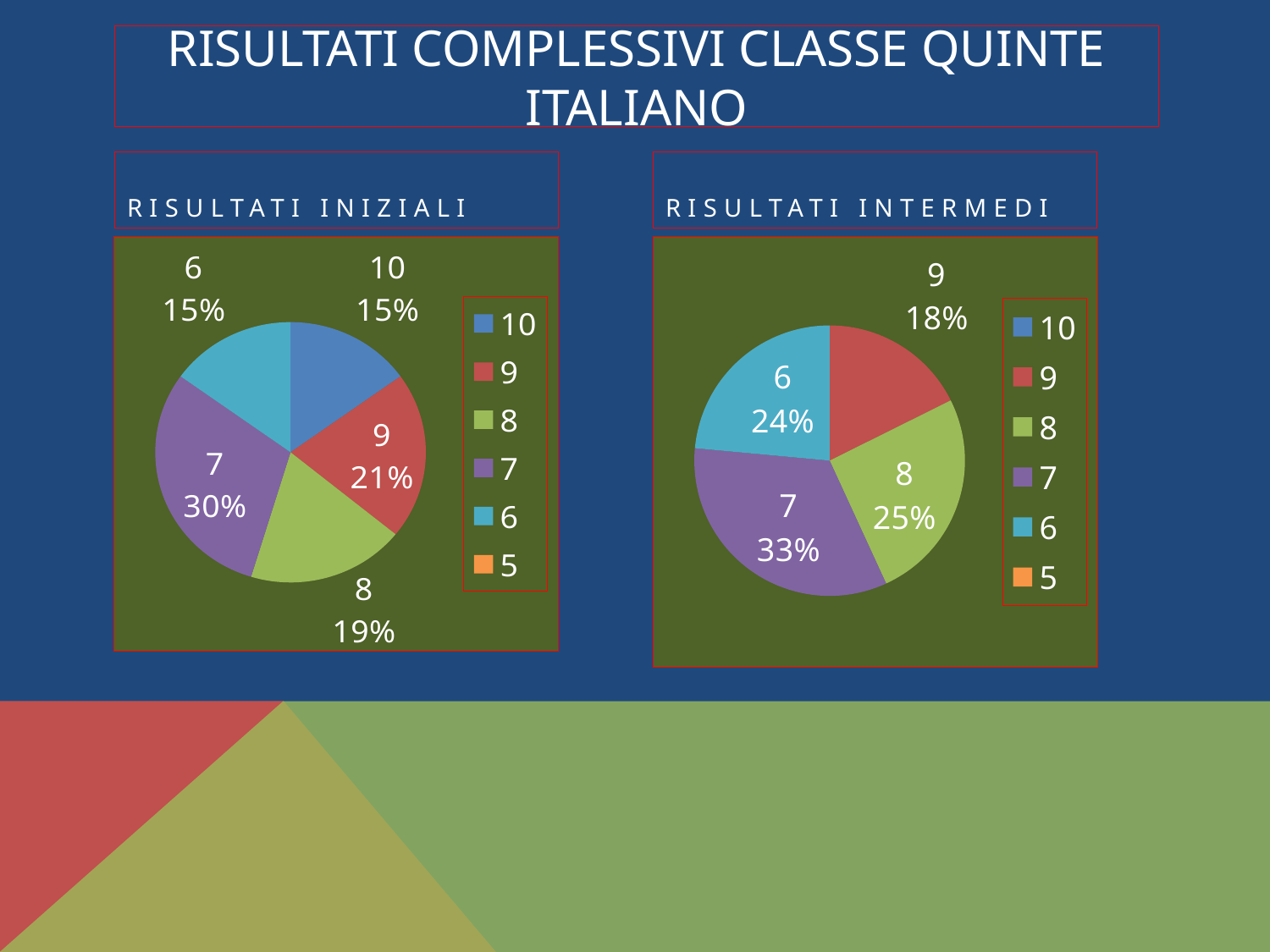
In the RISULTATI INIZIALI chart, what share of the pie does the slice for 9 represent? 21% What kind of chart is the RISULTATI INTERMEDI chart? Pie chart In the RISULTATI INIZIALI chart, which category has the largest slice? 7 In the RISULTATI INTERMEDI chart, what is the difference in percentage points between the slices for 7 and 9? 15 In the RISULTATI INTERMEDI chart, what share of the pie does the slice for 8 represent? 25% How many slices does the RISULTATI INTERMEDI pie chart have? 4 In the RISULTATI INTERMEDI chart, what share of the pie does the slice for 6 represent? 24% In the RISULTATI INTERMEDI chart, which category has the smallest slice? 9 How many slices does the RISULTATI INIZIALI pie chart have? 5 How many entries does the legend of the RISULTATI INIZIALI chart list? 6 In the RISULTATI INIZIALI chart, which slice is larger, 8 or 9? 9